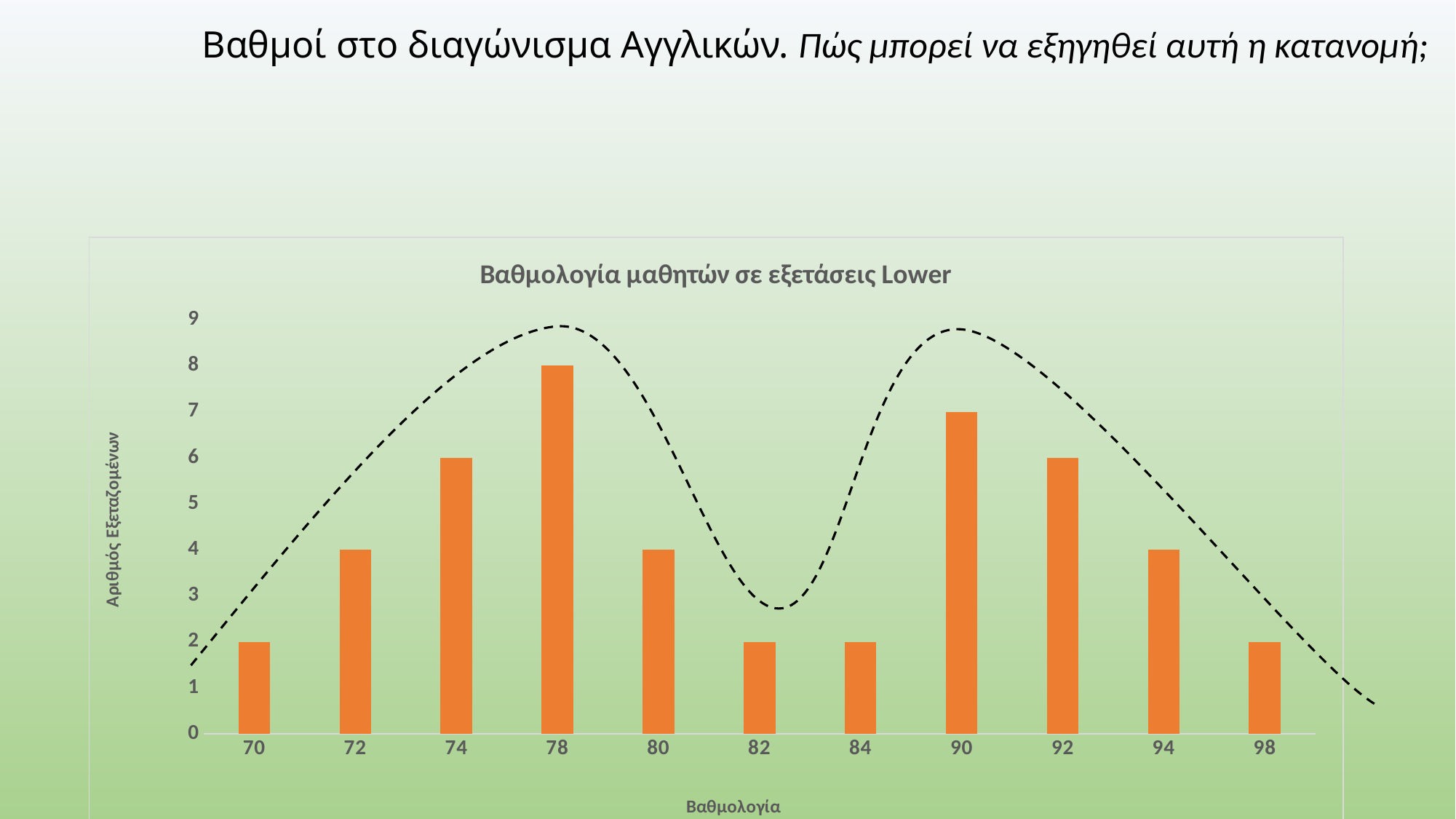
How many examinees scored 90? 7 Which score has the highest number of examinees? 78 What is the title of the chart? Βαθμολογία μαθητών σε εξετάσεις Lower Is the value for a score of 78 greater or less than 5? greater How many score categories are shown on the x axis? 11 What is the difference between the number of examinees scoring 78 and those scoring 90? 1 How many examinees scored 74? 6 What kind of chart is shown on the slide? bar chart How many examinees scored 78? 8 What is the label of the vertical axis? Αριθμός Εξεταζομένων Do the values rise or fall from a score of 70 to a score of 78? rise Which has more examinees, a score of 74 or a score of 90? 90